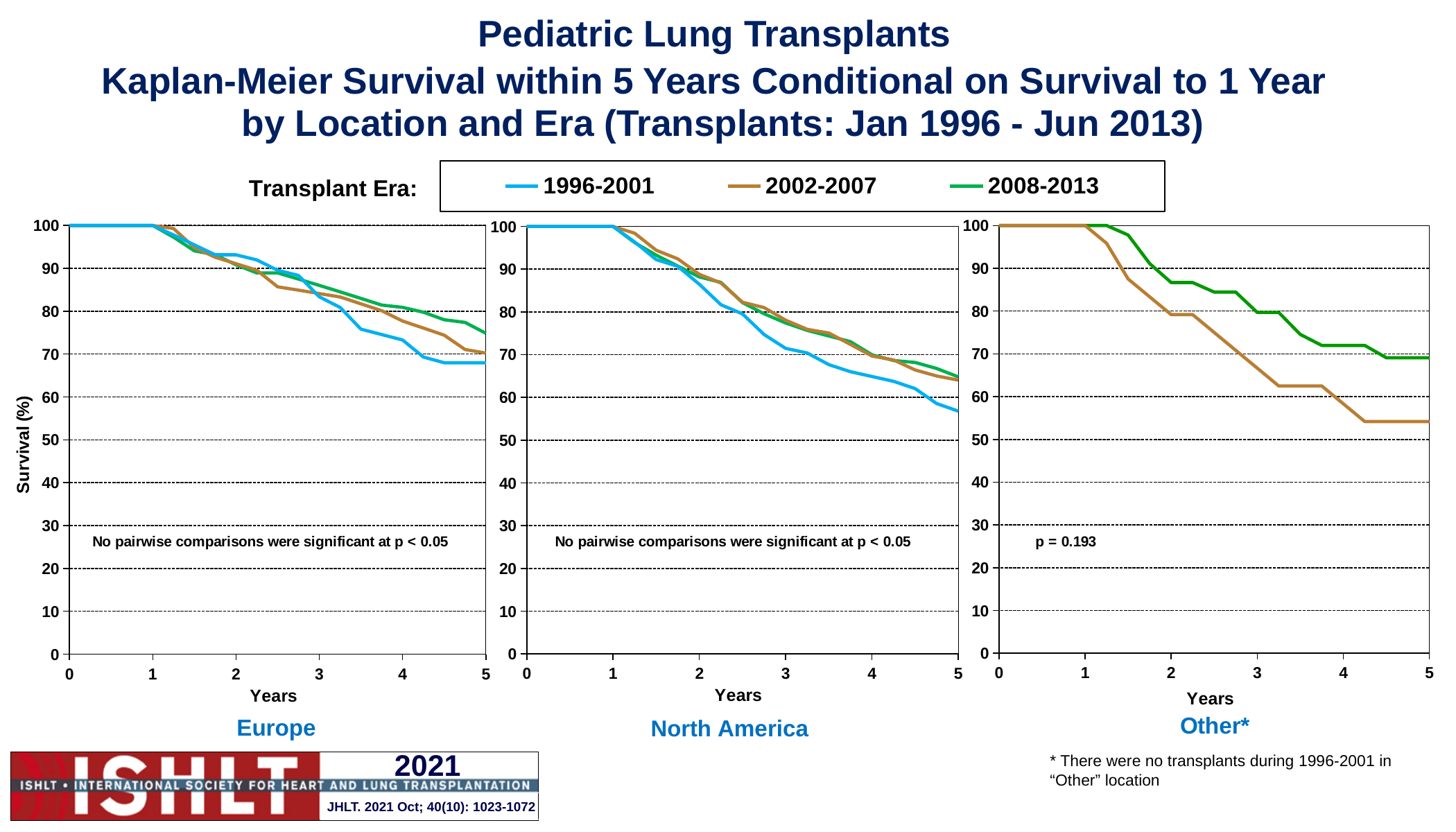
On the North America chart, is the 1996-2001 survival value at 5 years greater or less than 60? less On the North America chart, which era has higher survival at 5 years, 1996-2001 or 2002-2007? 2002-2007 On the Other* chart, which era has higher survival at 5 years, 2002-2007 or 2008-2013? 2008-2013 How many transplant eras does the legend list? 3 On the Europe chart, is the 2008-2013 survival value at 5 years greater or less than 70? greater On the Other* chart, is the 2002-2007 survival value at 5 years greater or less than 60? less What p-value is printed on the Other* chart? p = 0.193 What kind of chart is the Europe chart? line chart How many survival curves are plotted on the Other* chart? 2 On the Europe chart, does the 1996-2001 survival curve rise or fall as years increase? fall